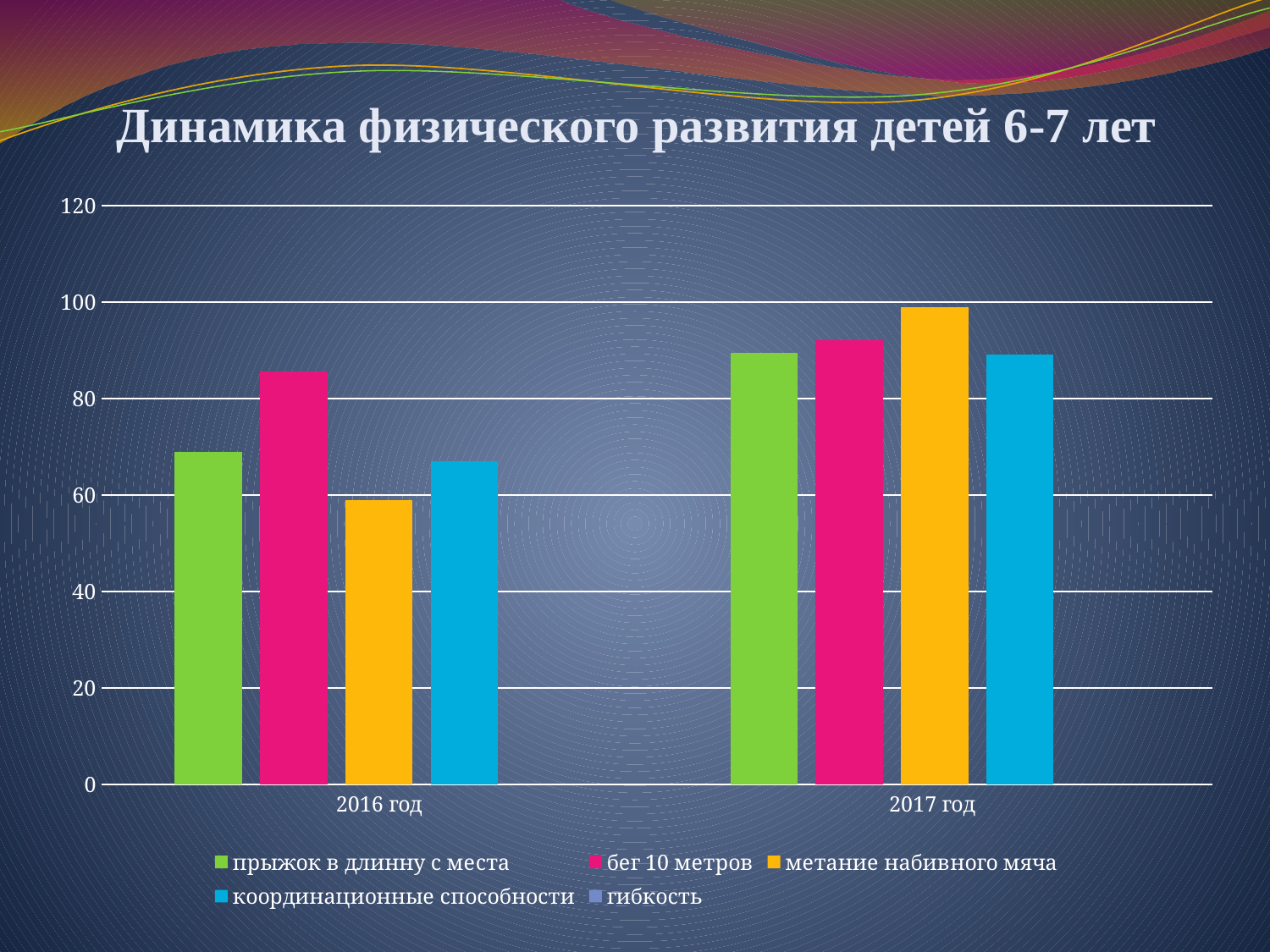
Is the value for метание набивного мяча in 2016 год greater or less than 80? less Is the value for метание набивного мяча in 2017 год greater or less than 80? greater Which series has the lowest value for 2016 год? метание набивного мяча Which is larger for координационные способности: the value for 2016 год or for 2017 год? 2017 год Which series has the highest value for 2016 год? бег 10 метров How many series does the legend list? 5 How many categories are shown on the x axis? 2 What is the title of the chart? Динамика физического развития детей 6-7 лет Is the value for бег 10 метров in 2016 год greater or less than 80? greater Which series has the highest value for 2017 год? метание набивного мяча What kind of chart is shown on the slide? bar chart Does the value for прыжок в длинну с места rise or fall from 2016 год to 2017 год? rises